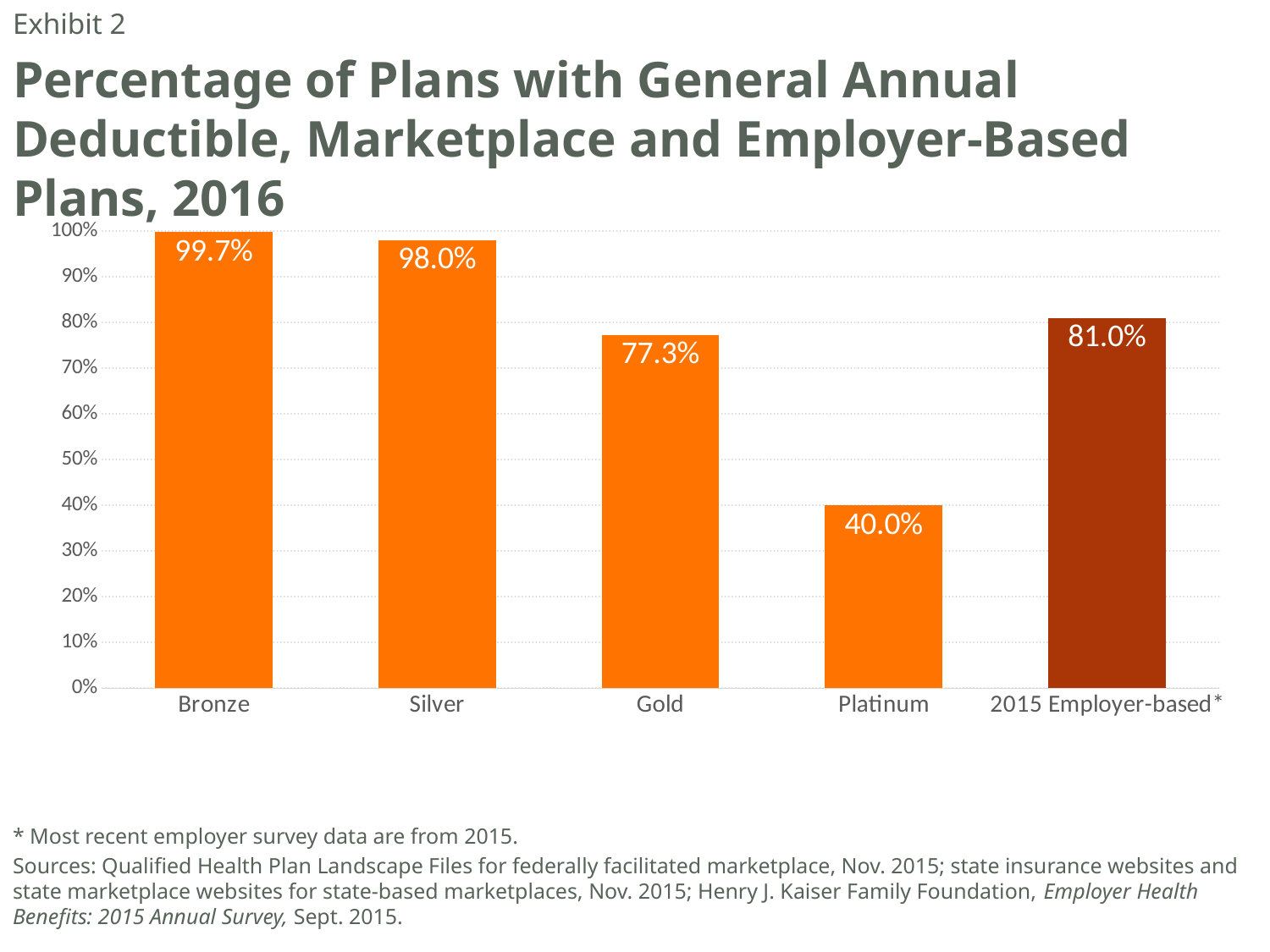
Which is larger, the value for Gold or the value for 2015 Employer-based? 2015 Employer-based How many categories are shown on the x axis? 5 What is the value shown for Platinum plans? 40.0% What kind of chart is shown on the slide? Bar chart Is the value for Gold greater or less than 80%? less What is the value shown for 2015 Employer-based plans? 81.0% Which bar is shown in a darker colour than the others? 2015 Employer-based Which category has the lowest percentage of plans with a general annual deductible? Platinum What is the difference between the Silver value and the 2015 Employer-based value? 17.0 percentage points Which category has the highest percentage of plans with a general annual deductible? Bronze What is the difference in percentage points between Gold and Platinum plans? 37.3 percentage points What percentage of Bronze plans have a general annual deductible? 99.7%